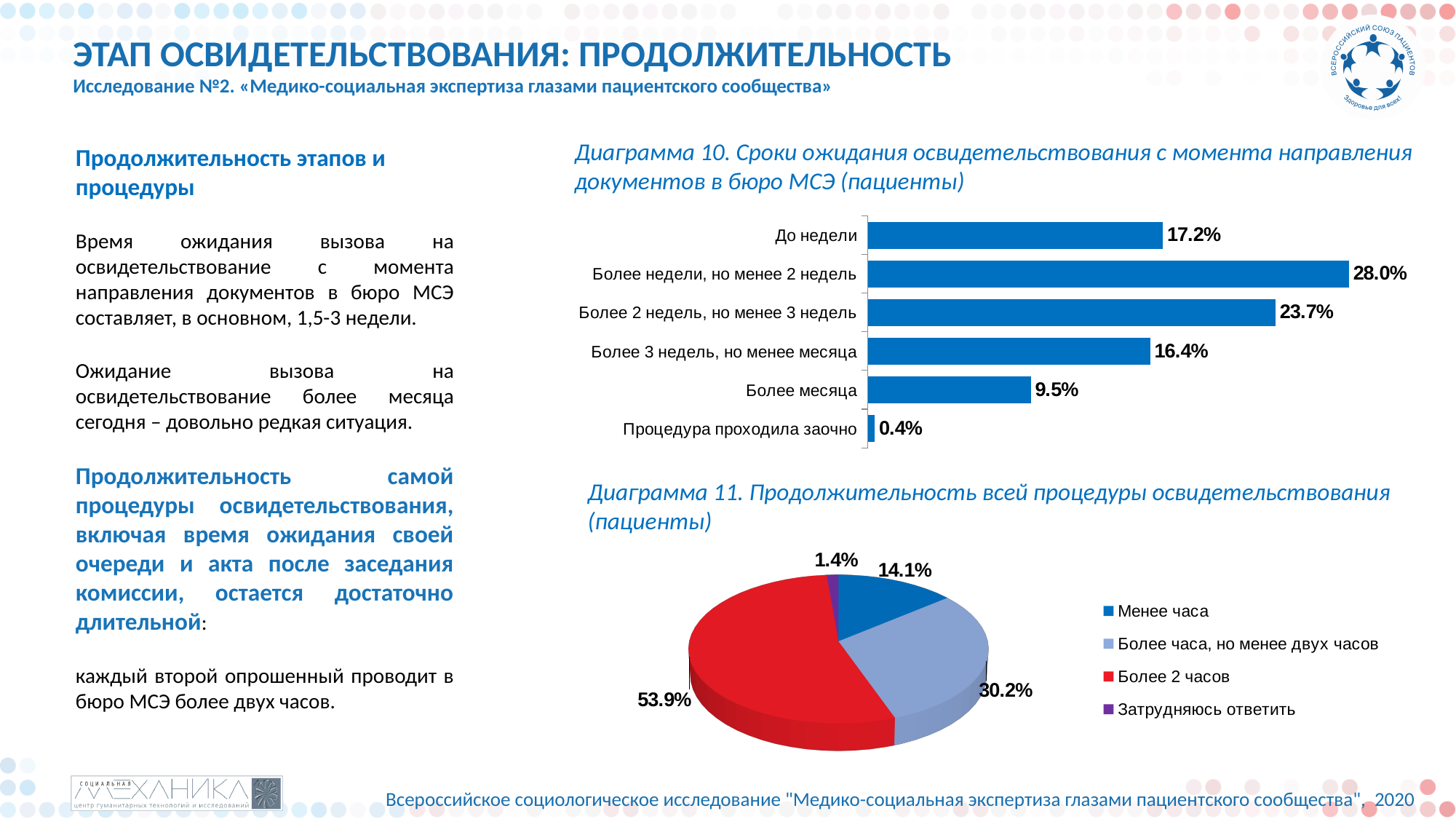
What type of chart is Диаграмма 10? Bar chart In Диаграмма 10, what is the value for «Более месяца»? 9.5% In Диаграмма 10, what is the difference between «Более 2 недель, но менее 3 недель» and «До недели»? 6.5% In Диаграмма 11, what is the value for «Менее часа»? 14.1% How many categories are shown in Диаграмма 10? 6 In Диаграмма 10, which category has the lowest value? Процедура проходила заочно How many entries does the legend of Диаграмма 11 list? 4 In Диаграмма 11, which slice is the smallest? Затрудняюсь ответить In Диаграмма 10, what is the value for «Более недели, но менее 2 недель»? 28.0% In Диаграмма 10, which category has the highest value? Более недели, но менее 2 недель In Диаграмма 11, what share of the pie is «Более 2 часов»? 53.9% In Диаграмма 10, which is larger: «До недели» or «Более 3 недель, но менее месяца»? До недели